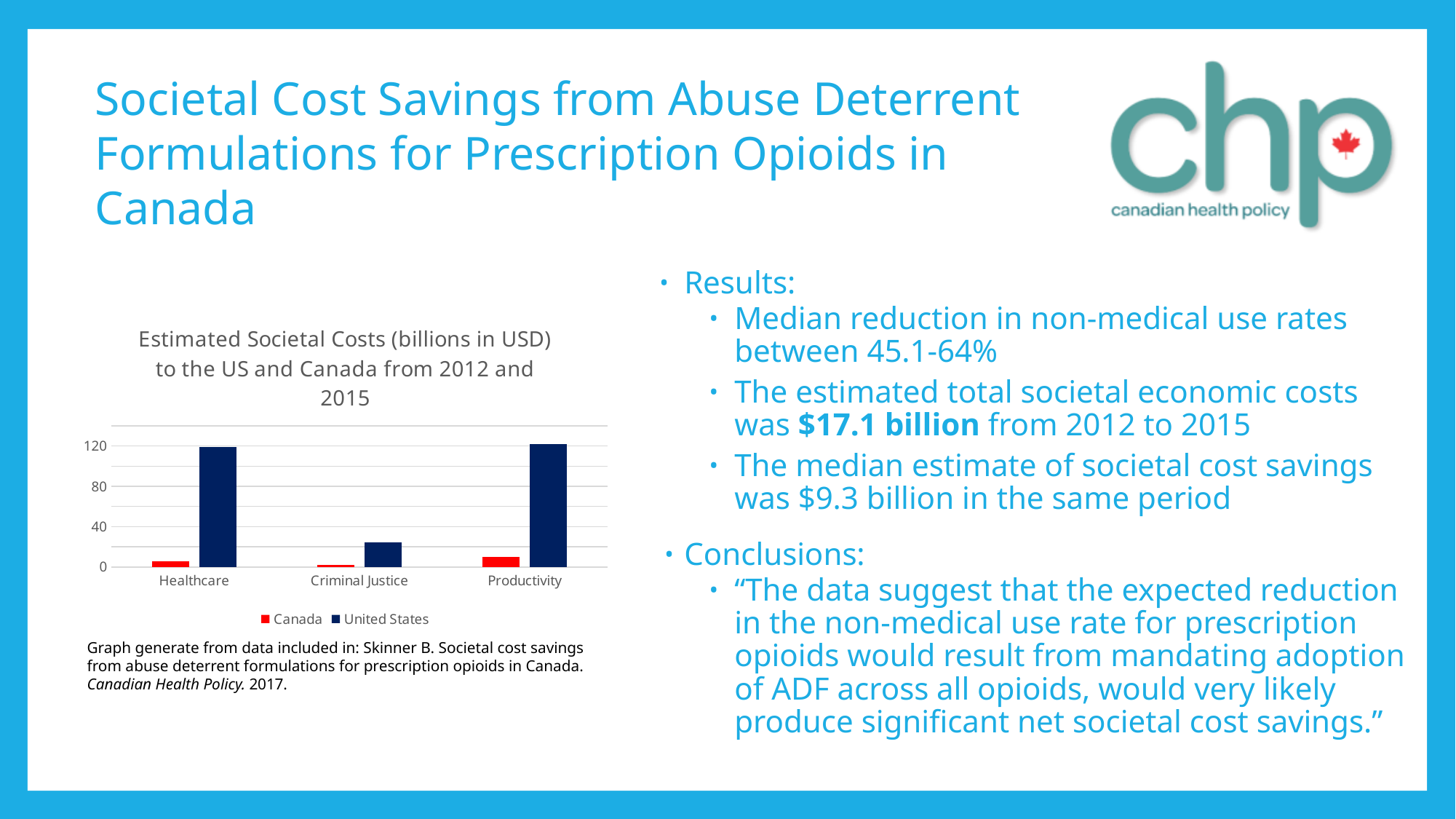
What is the title of the chart? Estimated Societal Costs (billions in USD) to the US and Canada from 2012 and 2015 Is the United States value for Criminal Justice greater or less than 40? less For which category is the Canada value lowest? Criminal Justice Is the United States value for Healthcare greater or less than 80? greater For which category is the United States value lowest? Criminal Justice Is the Canada value for Productivity greater or less than 40? less How many series does the chart's legend list? 2 How many categories are shown on the x axis of the chart? 3 What kind of chart is shown on the slide? Bar chart Which series is shown in red in the chart? Canada In the Healthcare category, which is larger: the Canada value or the United States value? United States